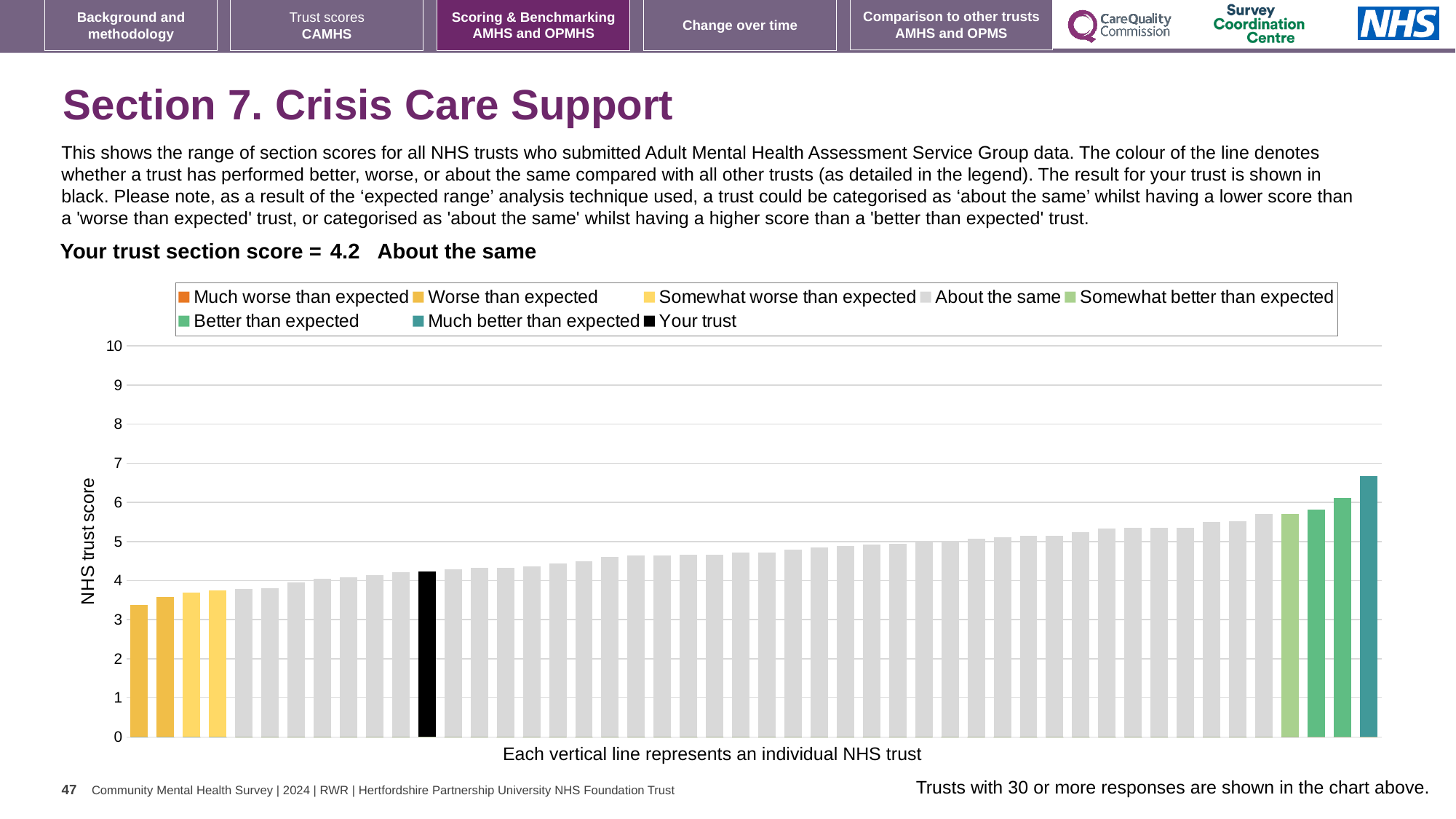
What is the label on the vertical axis of the chart? NHS trust score What is the section score for your trust shown on the slide? 4.2 Is your trust's bar higher or lower than the tallest bar in the chart? lower Is the value of the lowest bar in the chart greater or less than 4? less What kind of chart is shown on the slide? Bar chart How many entries does the chart legend list? 8 Do the bar values rise or fall from left to right across the chart? rise Which legend category does the tallest bar in the chart belong to? Much better than expected Is the value of the tallest bar in the chart greater or less than 6? greater Which legend category does the lowest bar in the chart belong to? Worse than expected Which category is your trust's section score placed in? About the same Is the value for your trust's bar greater or less than 4? greater